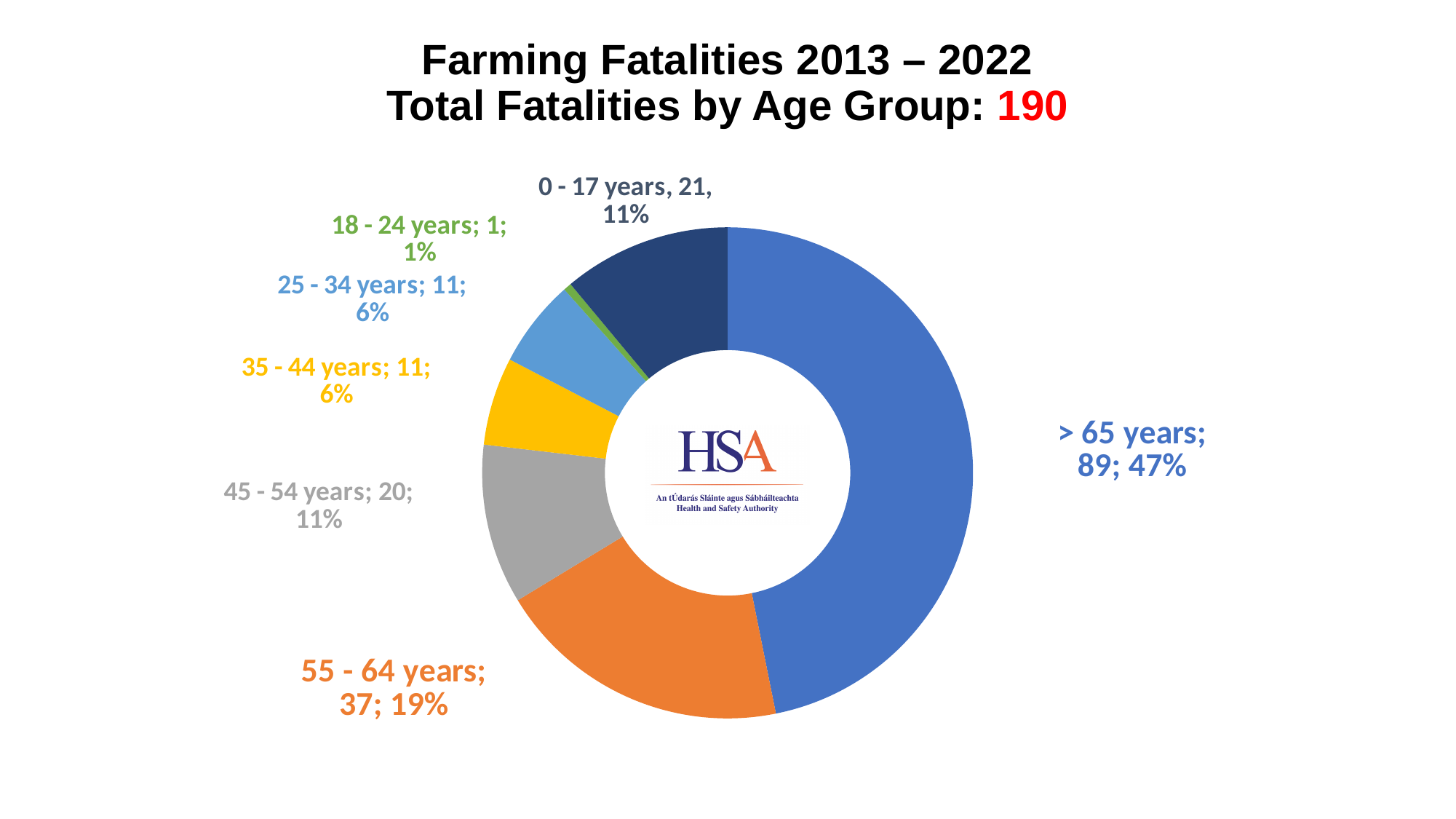
What is the difference in fatalities between the > 65 years and 55 - 64 years age groups? 52 Which age group has the lowest number of fatalities? 18 - 24 years What percentage share does the > 65 years age group have? 47% What percentage share does the 45 - 54 years age group have? 11% Which has more fatalities, the 0 - 17 years group or the 45 - 54 years group? 0 - 17 years Which age group has the highest number of fatalities? > 65 years What kind of chart is shown on the slide? Pie chart (doughnut) What is the total number of fatalities shown in the chart title? 190 How many fatalities are shown for the 55 - 64 years age group? 37 What colour is the slice for the 35 - 44 years age group? Yellow How many age groups are shown in the chart? 7 How many fatalities are shown for the > 65 years age group? 89